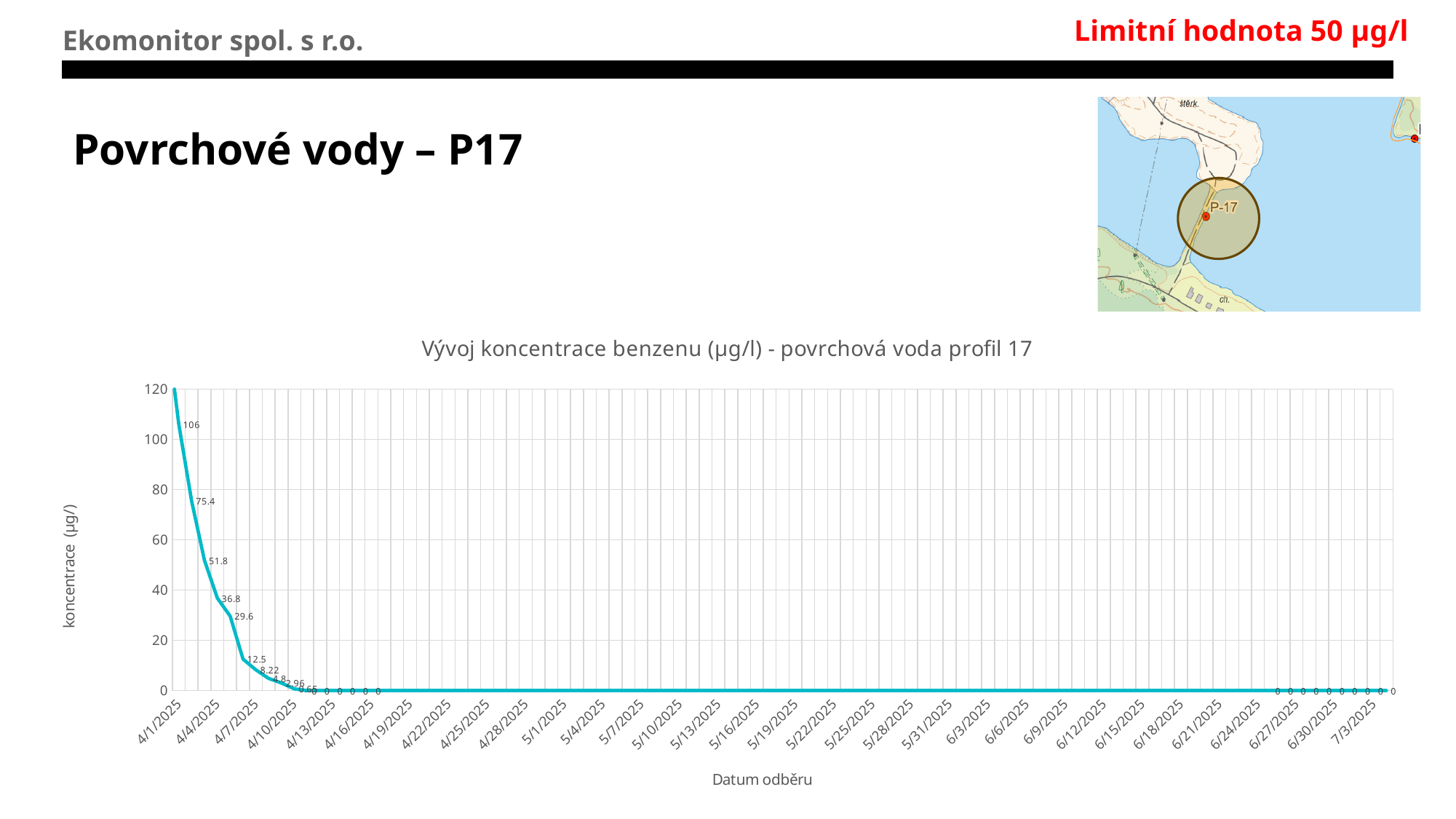
What is the value plotted at 6/27/2025? 0 What kind of chart is shown on the slide? line chart What is the title of the x axis of the chart? Datum odběru What is the difference between the data labels 51.8 and 36.8? 15 What is the value plotted at 7/3/2025? 0 Do the values in the chart rise or fall along the x axis from 4/1/2025 onward? fall What is the title of the chart? Vývoj koncentrace benzenu (µg/l) - povrchová voda profil 17 What is the difference between the data labels 106 and 75.4? 30.6 Which date has the larger value, 4/1/2025 or 7/3/2025? 4/1/2025 What is the highest data label printed on the chart? 106 Is the value at 4/1/2025 greater or less than 100? greater